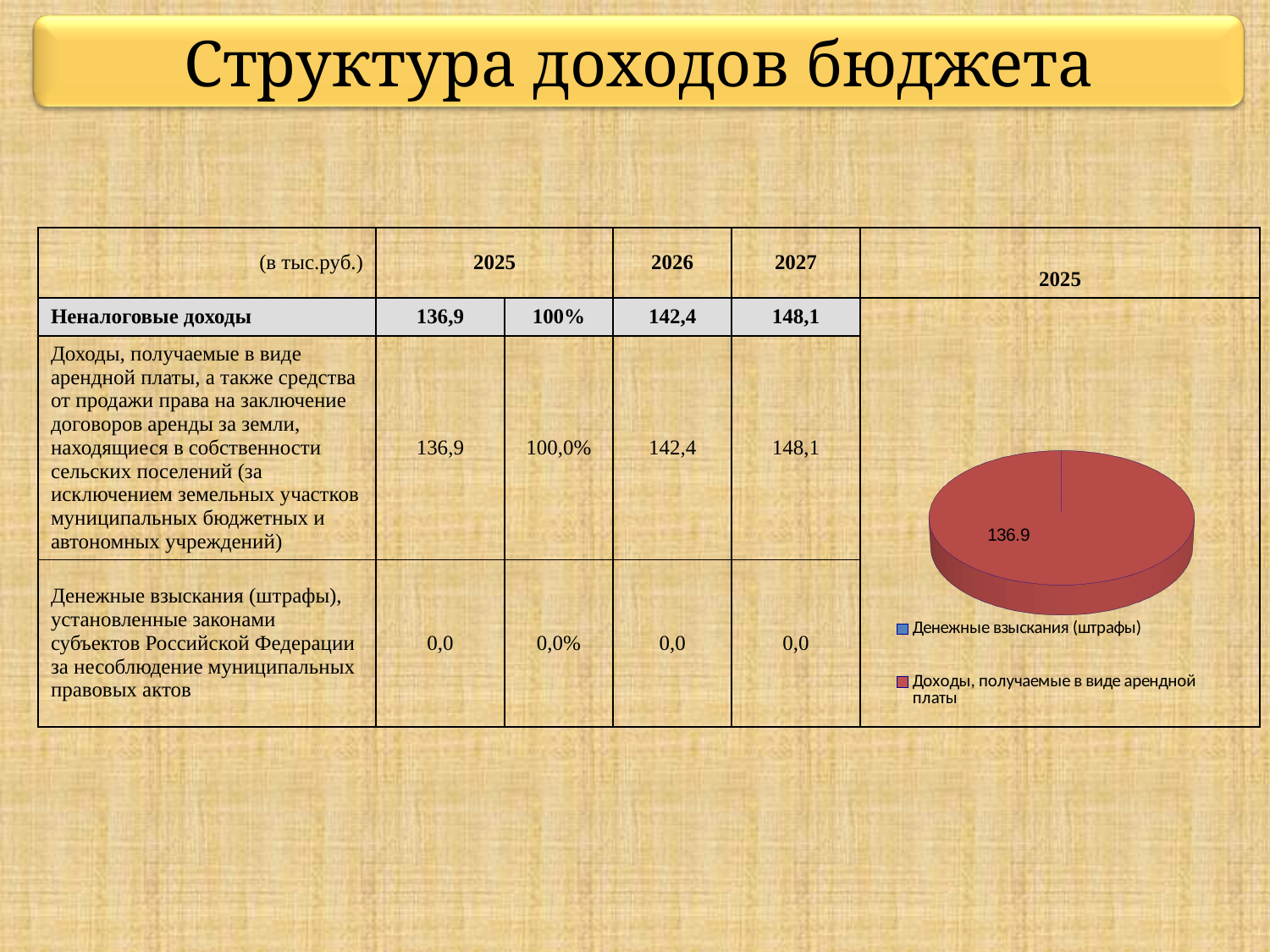
Is the value shown on the pie chart's slice greater or less than 100? greater How many slices are visible in the pie chart? 1 What is the title of the pie chart? 2025 What value is printed on the pie chart's slice? 136.9 How many entries does the legend of the pie chart list? 2 What kind of chart is shown on the slide? pie chart Which legend category does the visible slice of the pie chart represent? Доходы, получаемые в виде арендной платы What colour is the slice for Доходы, получаемые в виде арендной платы in the pie chart? red Which category in the pie chart has the larger value, Денежные взыскания (штрафы) or Доходы, получаемые в виде арендной платы? Доходы, получаемые в виде арендной платы